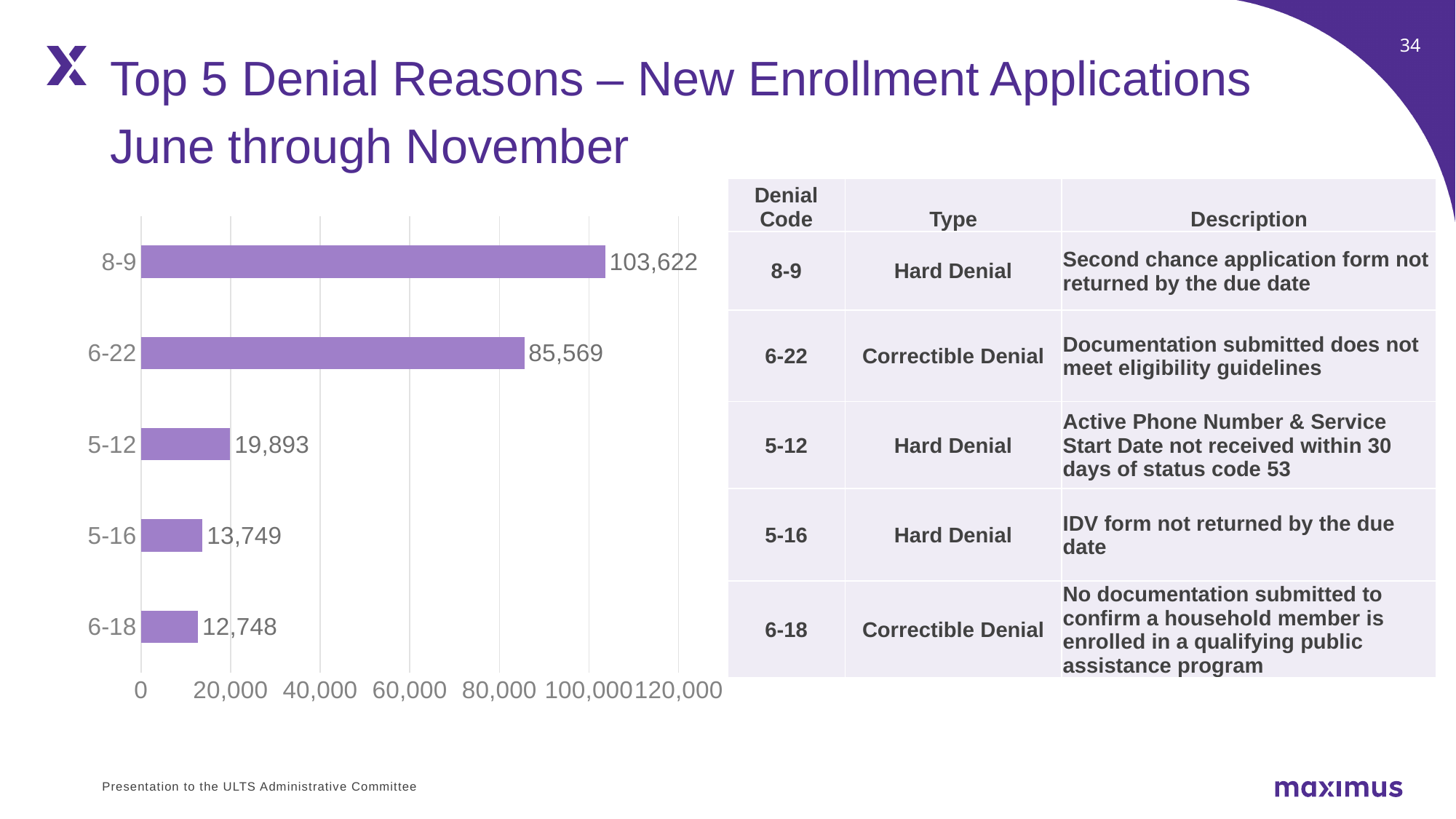
How many denial codes are shown in the chart? 5 What is the value for denial code 5-12? 19,893 What is the value for denial code 8-9? 103,622 What kind of chart is shown on the slide? bar chart Which denial code has the highest value? 8-9 Which is larger, the value for 5-12 or the value for 5-16? 5-12 What is the value for denial code 6-18? 12,748 Which denial code has the lowest value? 6-18 What is the difference between the values for 8-9 and 6-22? 18,053 What is the difference between the values for 5-16 and 6-18? 1,001 What is the value for denial code 6-22? 85,569 Is the value for 6-22 greater or less than 80,000? greater